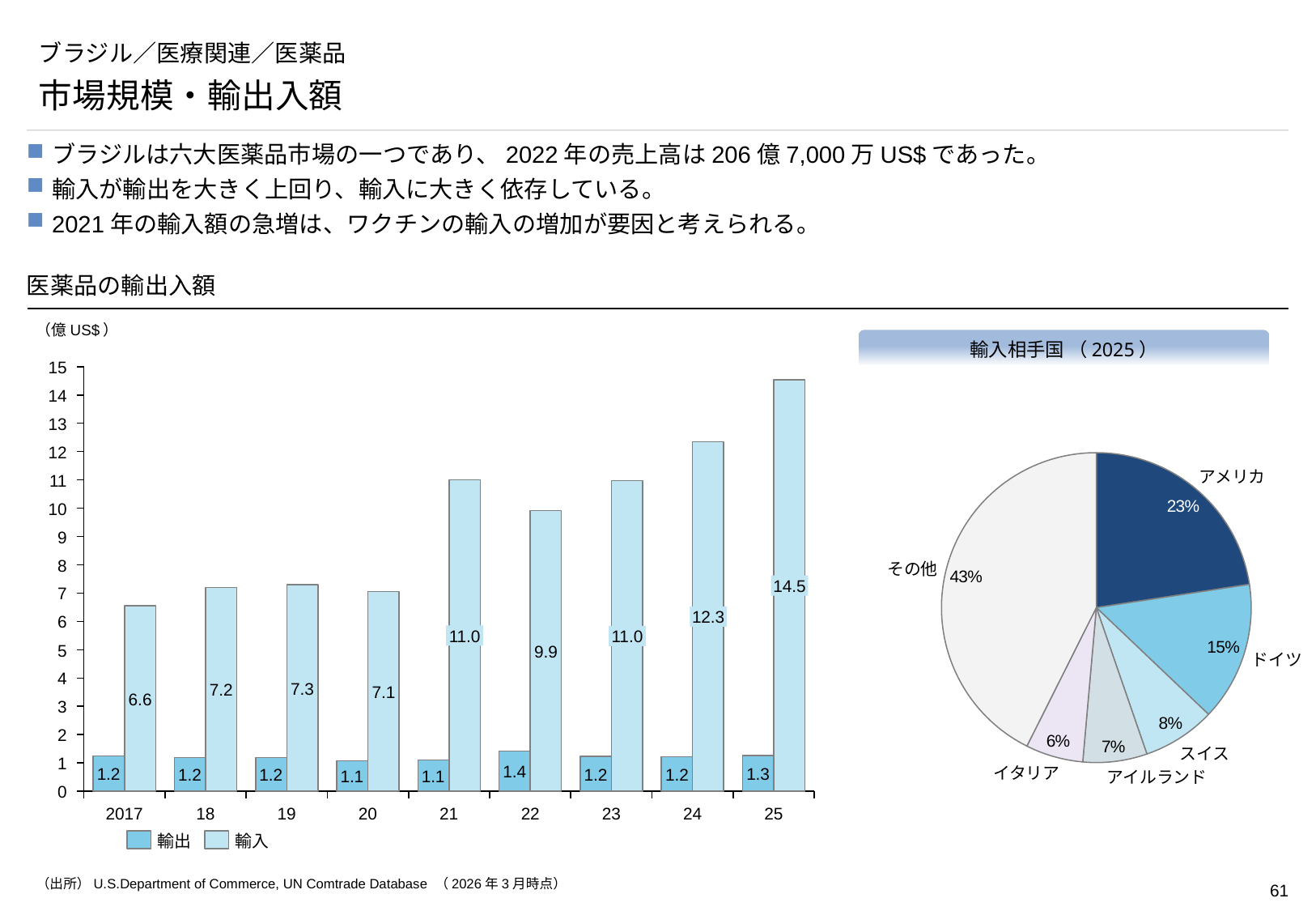
In the bar chart 医薬品の輸出入額, which year has the lowest 輸入 value? 2017 In the bar chart 医薬品の輸出入額, what is the difference between the 輸入 values for 25 and 24? 2.2 In the bar chart 医薬品の輸出入額, what is the 輸出 value for 22? 1.4 In the bar chart 医薬品の輸出入額, how many years are shown on the x axis? 9 In the pie chart 輸入相手国 (2025), which named country has the smallest share? イタリア In the bar chart 医薬品の輸出入額, which is larger, the 輸入 value for 21 or for 22? 21 In the bar chart 医薬品の輸出入額, what is the 輸入 value for 2017? 6.6 In the pie chart 輸入相手国 (2025), what is the difference between the shares of ドイツ and スイス? 7% What kind of chart is 輸入相手国 (2025)? pie chart In the pie chart 輸入相手国 (2025), what share does アメリカ have? 23% In the bar chart 医薬品の輸出入額, which year has the highest 輸入 value? 25 In the bar chart 医薬品の輸出入額, how many series does the legend list? 2